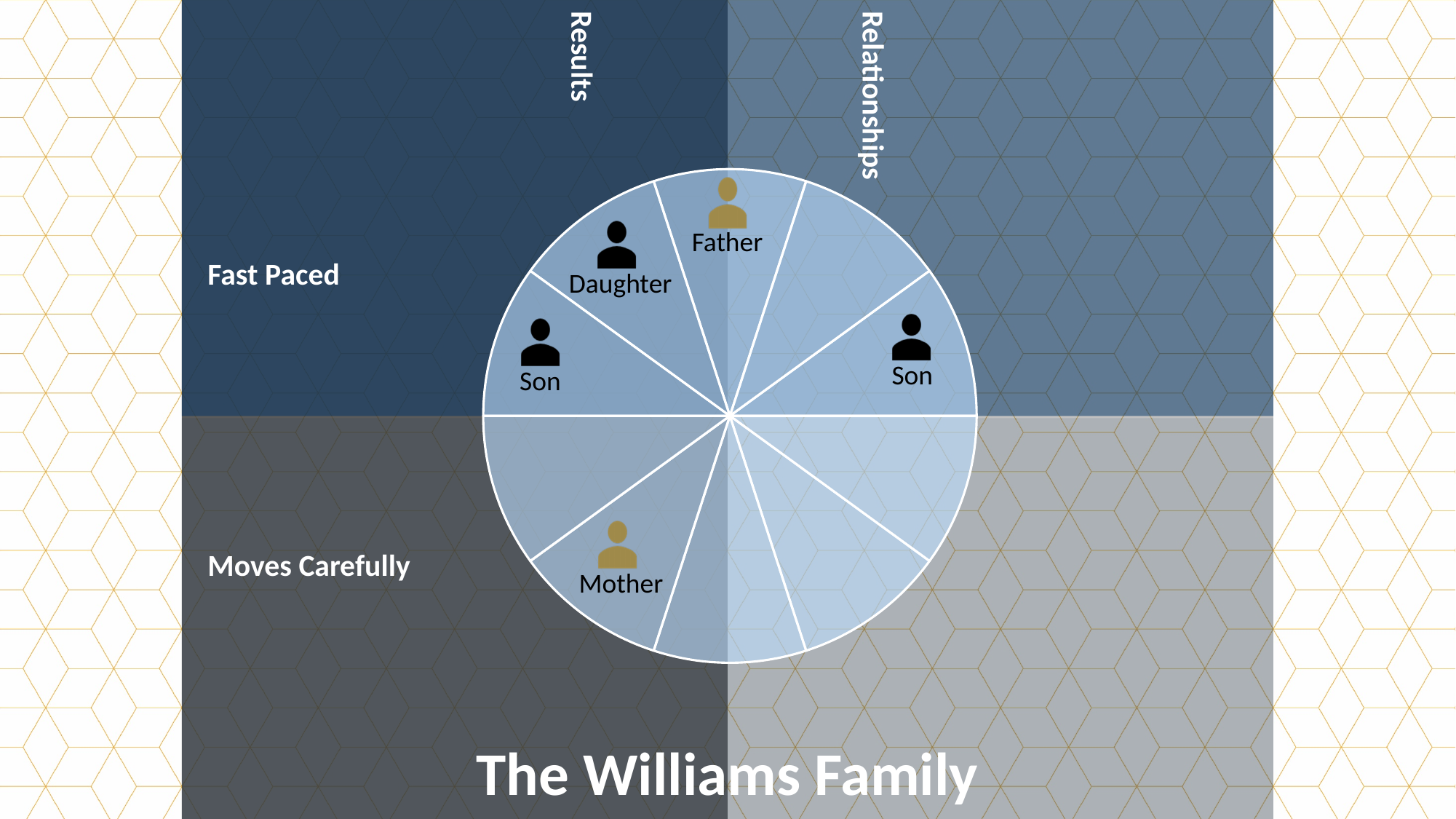
Which family member is placed in the Results / Moves Carefully quadrant of the chart? Mother What is the title shown below the chart? The Williams Family How many slices does the pie chart have? 10 What are the two labels on the left side of the chart describing the top and bottom halves? Fast Paced, Moves Carefully Which family member is placed in the Relationships / Fast Paced quadrant of the chart? Son How many family members are labelled on the pie chart? 5 What kind of chart is shown on the slide? pie chart How many family members are labelled Son on the chart? 2